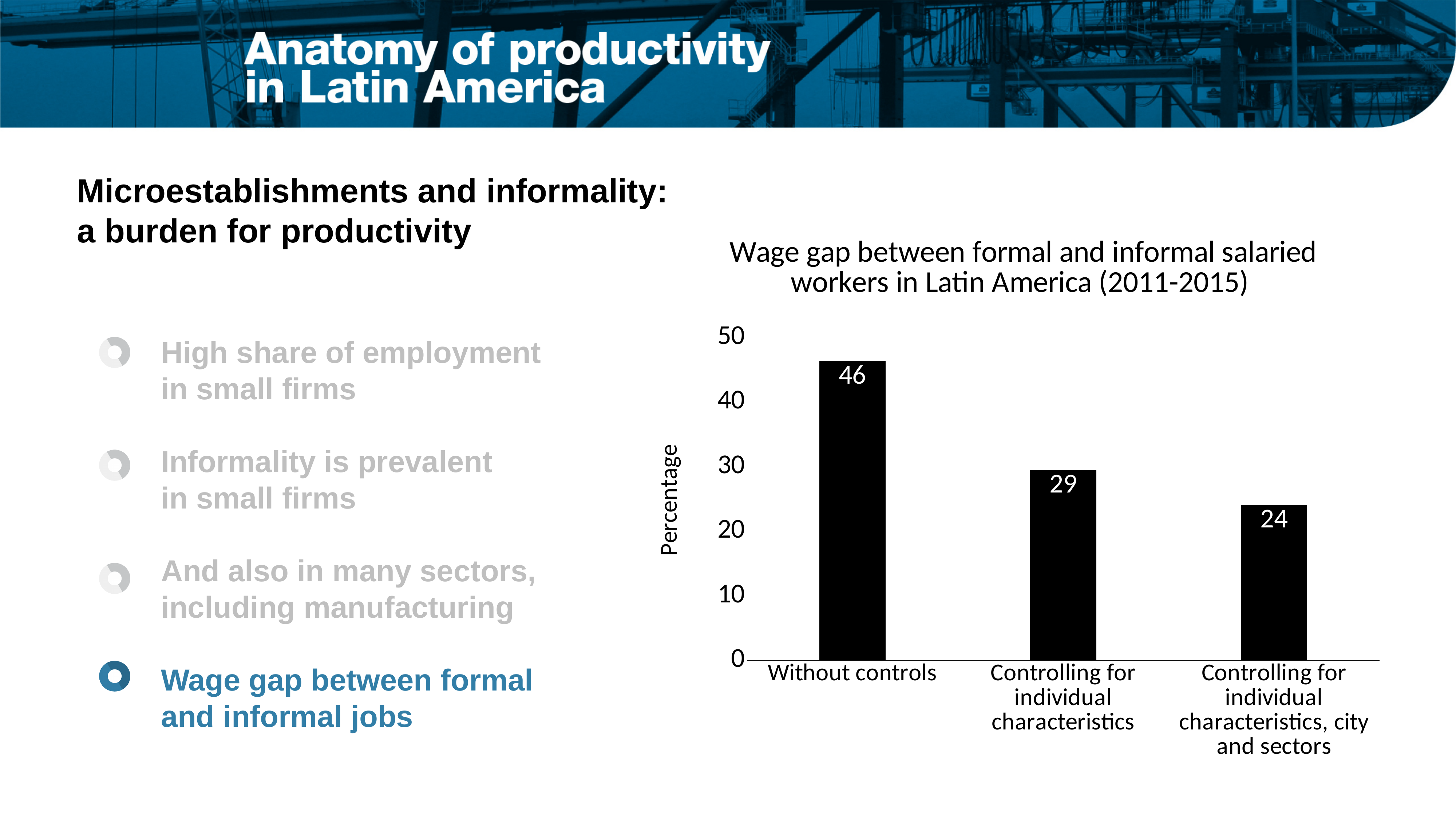
What is the difference between the wage gap 'Controlling for individual characteristics' and 'Controlling for individual characteristics, city and sectors'? 5 What kind of chart is shown on the slide? Bar chart What is the wage gap value for 'Controlling for individual characteristics, city and sectors'? 24 How many categories are shown on the chart? 3 What is the label of the vertical axis? Percentage What is the wage gap value for 'Controlling for individual characteristics'? 29 Is the value for 'Controlling for individual characteristics' greater or less than 30? less What is the difference between the wage gap 'Without controls' and 'Controlling for individual characteristics'? 17 What is the wage gap value for 'Without controls'? 46 Which is larger: the wage gap 'Without controls' or 'Controlling for individual characteristics, city and sectors'? Without controls Which category has the lowest wage gap? Controlling for individual characteristics, city and sectors Which category has the highest wage gap? Without controls